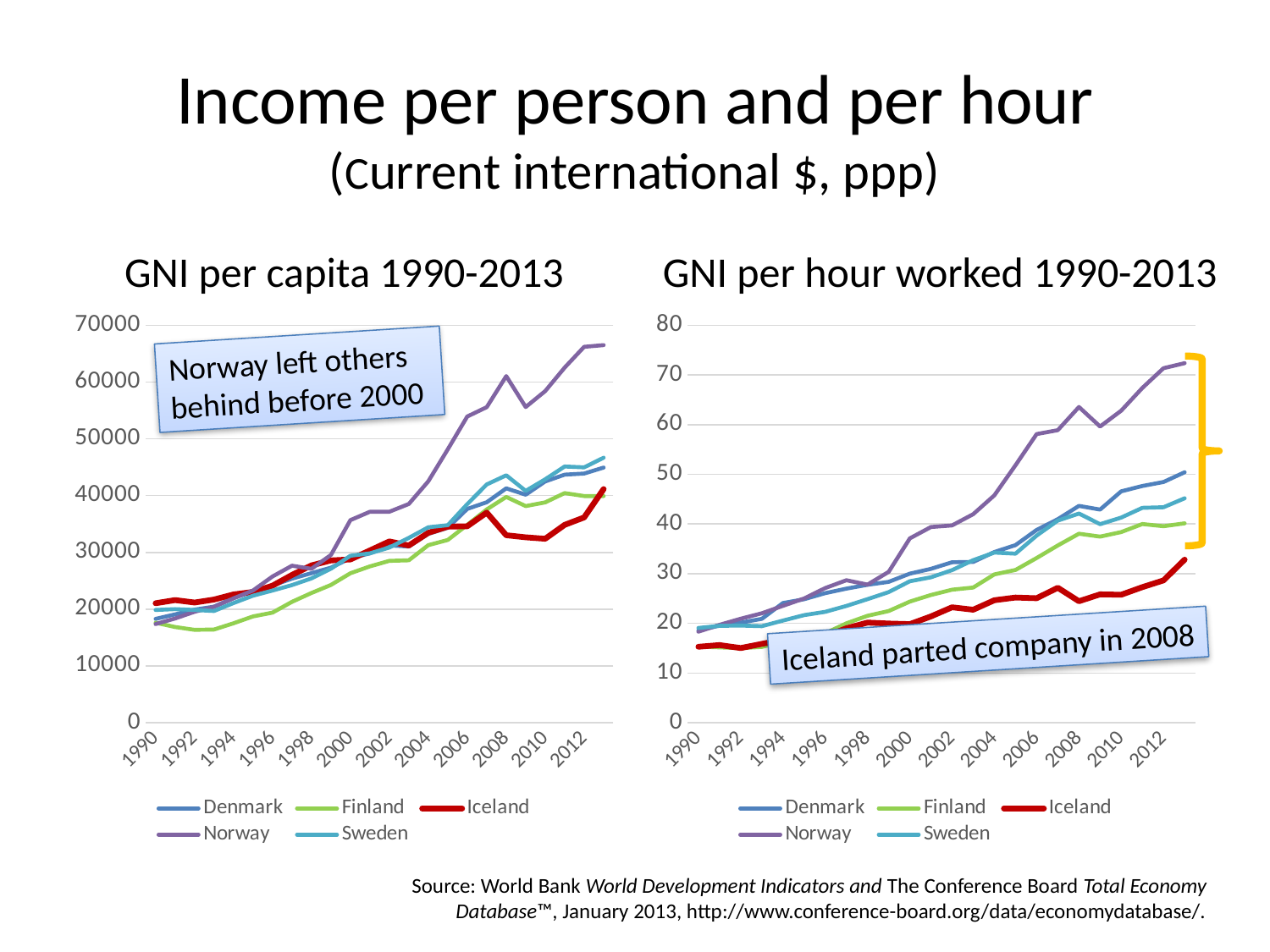
In the 'GNI per capita 1990-2013' chart, is the value for Norway in 2013 greater or less than 60000? greater In the 'GNI per hour worked 1990-2013' chart, is the value for Iceland in 1990 greater or less than 20? less In the 'GNI per capita 1990-2013' chart, which country has the highest value in 2013? Norway In the 'GNI per hour worked 1990-2013' chart, is the value for Sweden in 2013 greater or less than 40? greater How many series does the legend of the 'GNI per hour worked 1990-2013' chart list? 5 What does the annotation on the 'GNI per hour worked 1990-2013' chart say? Iceland parted company in 2008 In the 'GNI per capita 1990-2013' chart, does the value for Norway generally rise or fall from 1990 to 2013? rise In the 'GNI per hour worked 1990-2013' chart, which country has the lowest value in 2013? Iceland In the 'GNI per hour worked 1990-2013' chart, which is larger in 2013, Norway or Iceland? Norway What kind of chart is the 'GNI per capita 1990-2013' chart? line chart In the 'GNI per hour worked 1990-2013' chart, which country has the highest value in 2013? Norway